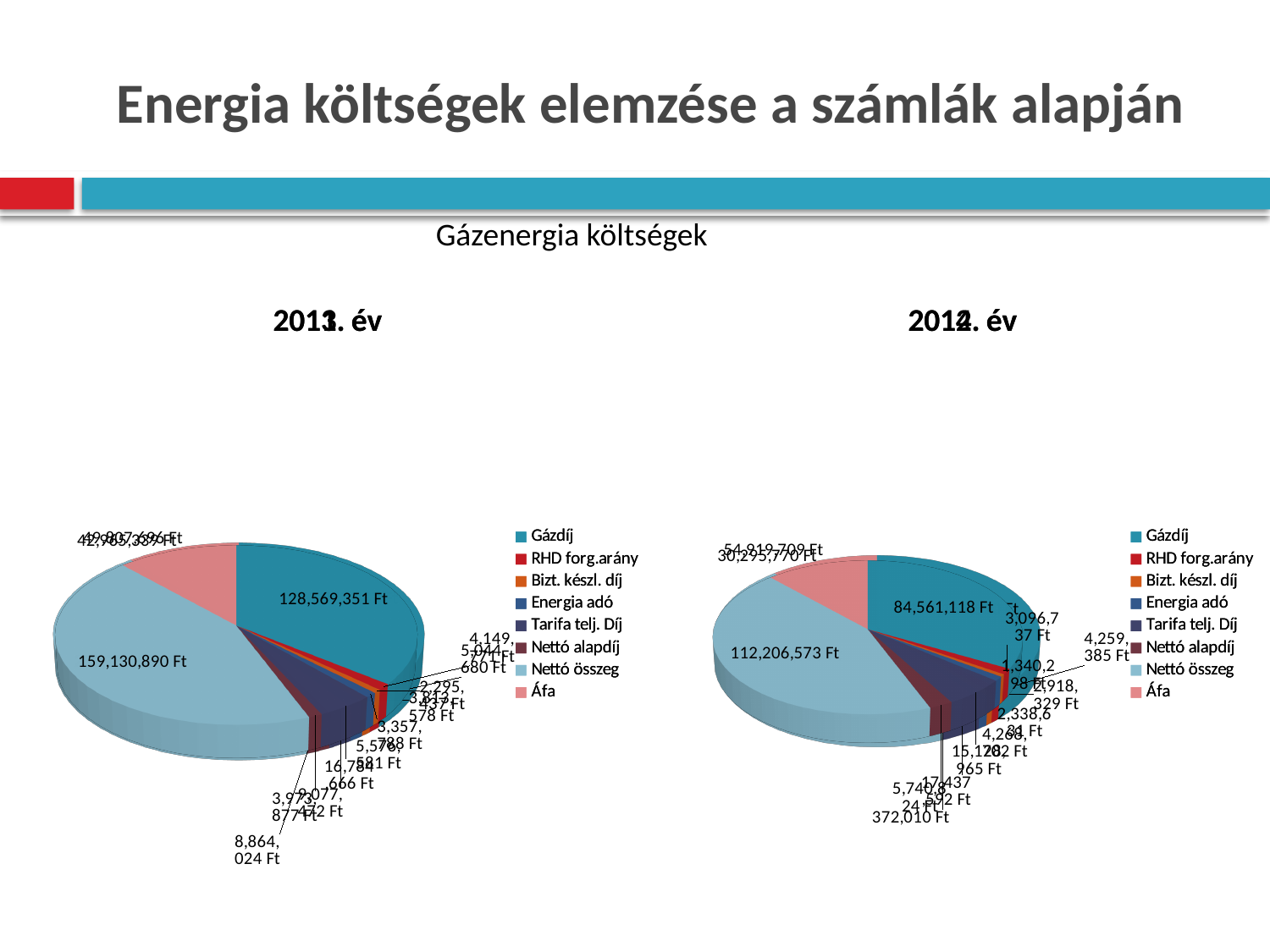
Comparing the two pie charts, is the Gázdíj value larger in the left chart or the right chart? Left chart In the left pie chart, what is the difference between Nettó összeg and Gázdíj? 30,561,539 Ft What type of chart is used on this slide? Pie chart In the right pie chart, what is the value shown for Nettó összeg? 112,206,573 Ft How many entries does the legend of the left pie chart list? 8 In the left pie chart, which category has the largest slice? Nettó összeg In the left pie chart, what is the value shown for Nettó összeg? 159,130,890 Ft In the left pie chart, which is larger: Gázdíj or Nettó összeg? Nettó összeg In the right pie chart, what is the value shown for Gázdíj? 84,561,118 Ft In the right pie chart, what is the difference between Nettó összeg and Gázdíj? 27,645,455 Ft In the left pie chart, what is the value shown for Gázdíj? 128,569,351 Ft In the right pie chart, which category has the largest slice? Nettó összeg